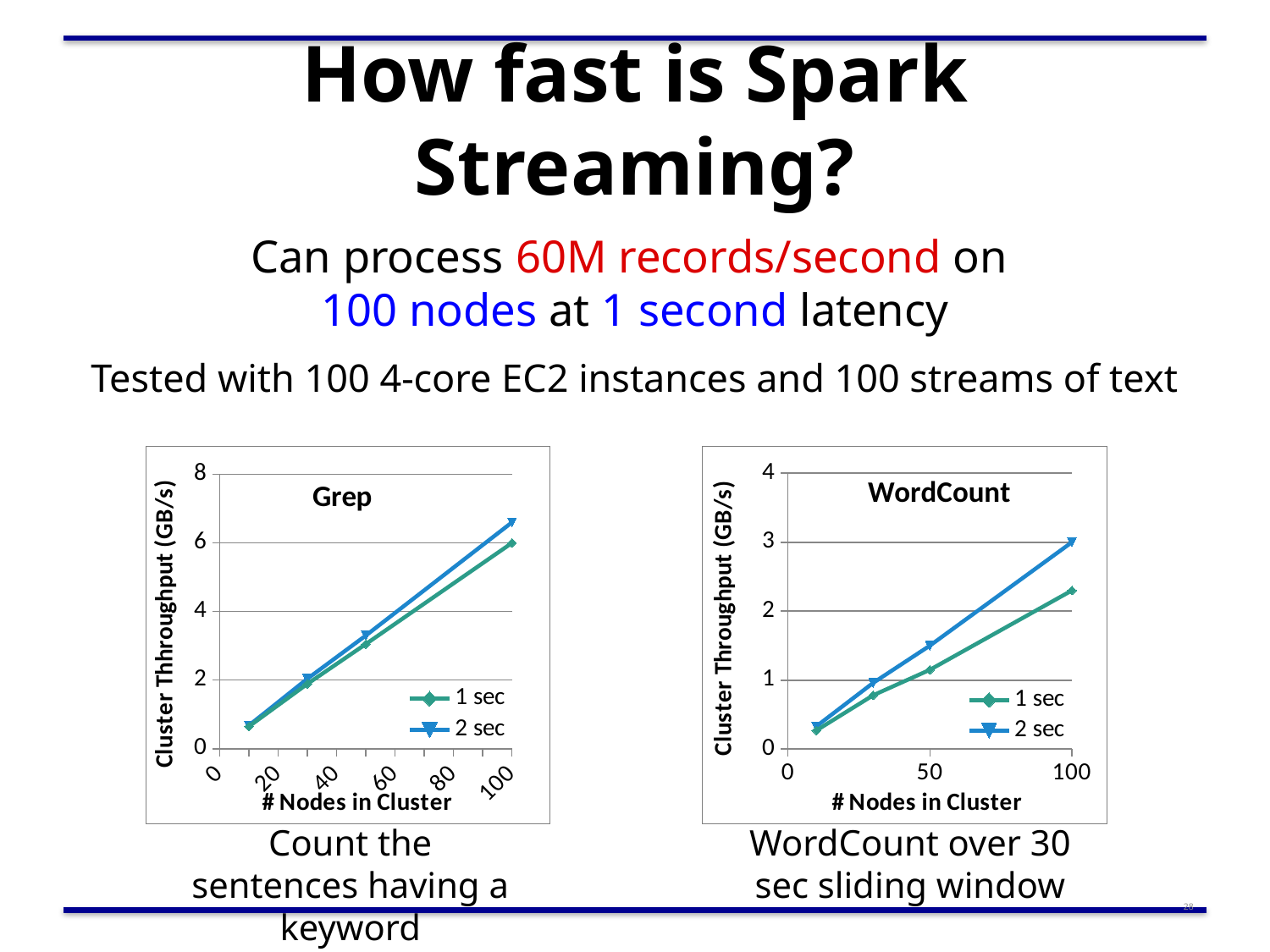
In the WordCount chart, is the 2 sec throughput at 50 nodes greater or less than 1 GB/s? greater How many series does the legend of the WordCount chart list? 2 What are the two legend entries in the Grep chart? 1 sec and 2 sec In the Grep chart, is the 2 sec throughput at 100 nodes greater or less than 6 GB/s? greater In the Grep chart, at 100 nodes, which series has the higher throughput, 1 sec or 2 sec? 2 sec In the WordCount chart, is the 1 sec throughput at 100 nodes greater or less than 2 GB/s? greater In the WordCount chart, does the 2 sec series rise or fall as the number of nodes increases? rise What kind of chart is the Grep chart? line chart In the Grep chart, does cluster throughput rise or fall as the number of nodes increases? rise What is the x-axis title of the WordCount chart? # Nodes in Cluster In the WordCount chart, at 100 nodes, which series has the higher throughput, 1 sec or 2 sec? 2 sec